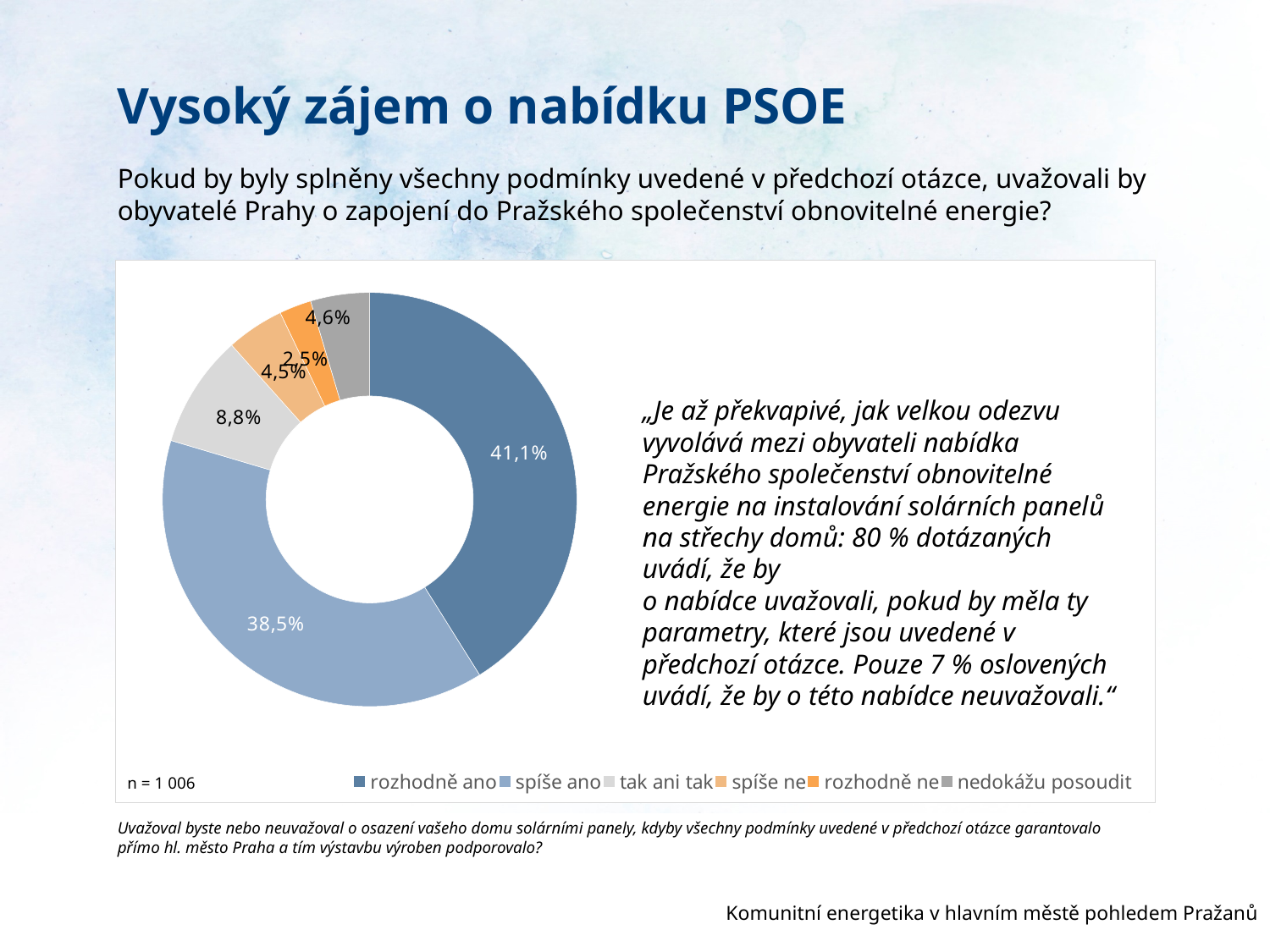
Which answer category has the largest share of the chart? rozhodně ano What share of respondents answered "rozhodně ano"? 41,1% What kind of chart is shown on the slide? pie (doughnut) chart What share of respondents answered "spíše ano"? 38,5% Which answer category has the smallest share of the chart? rozhodně ne Which is larger, the share for "tak ani tak" or the share for "spíše ne"? tak ani tak What share of respondents answered "tak ani tak"? 8,8% What is the combined share of "rozhodně ano" and "spíše ano"? 79,6% What share of respondents answered "nedokážu posoudit"? 4,6% How many answer categories does the chart show? 6 What is the difference in percentage points between "rozhodně ano" and "spíše ano"? 2,6 What sample size (n) is stated on the chart? n = 1 006